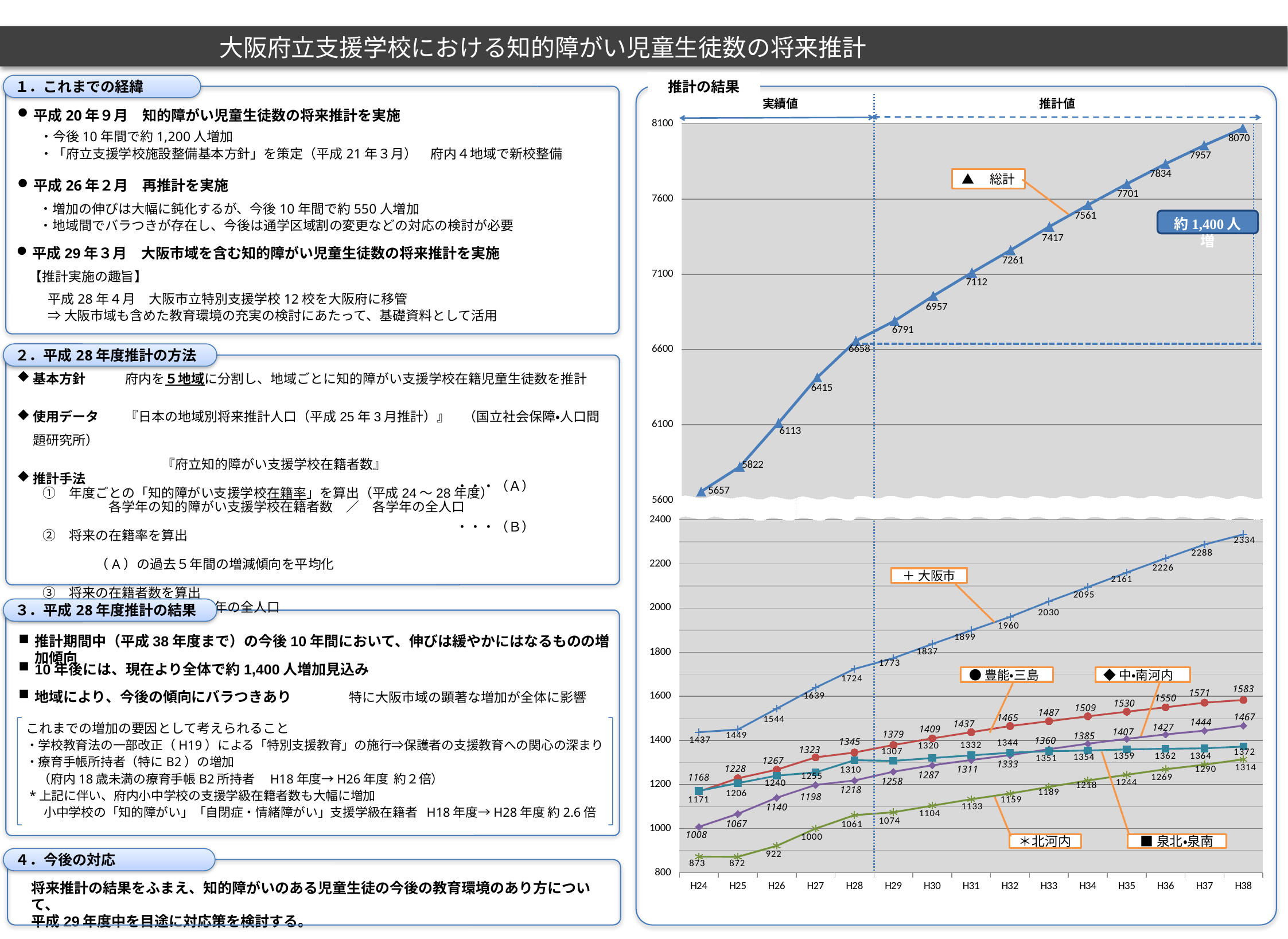
What kind of chart is the 推計の結果 chart? line chart In the 推計の結果 chart, what is the 大阪市 value for H38? 2334 In the 推計の結果 chart, what is the 総計 value for H38? 8070 In the 推計の結果 chart, by how much does the 総計 value increase from H24 to H38? 2413 In the 推計の結果 chart, what is the 中・南河内 value for H28? 1218 In the 推計の結果 chart, which regional series has the highest value at H38? 大阪市 In the 推計の結果 chart, which regional series has the lowest value at H24? 北河内 In the 推計の結果 chart, does the 総計 series rise or fall from H24 to H38? rise In the 推計の結果 chart, what is the difference between the 北河内 values for H38 and H24? 441 In the 推計の結果 chart, which is larger at H38: 豊能・三島 or 泉北・泉南? 豊能・三島 In the 推計の結果 chart, what is the 総計 value for H24? 5657 How many year categories are shown on the x axis of the 推計の結果 chart? 15